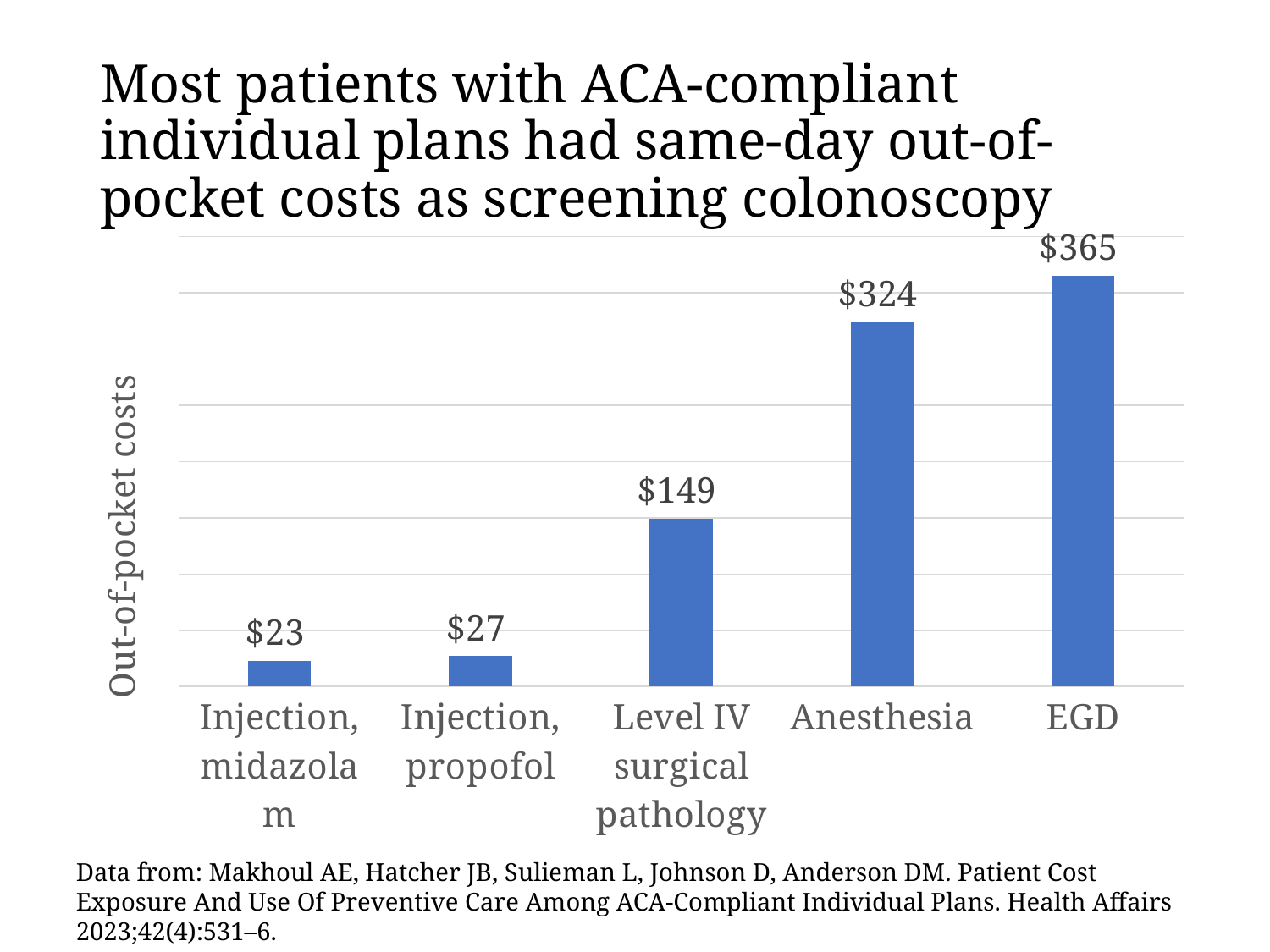
How many categories are shown in the chart? 5 Which category has the highest out-of-pocket cost? EGD Which has a higher out-of-pocket cost, Anesthesia or Level IV surgical pathology? Anesthesia What kind of chart is shown on the slide? Bar chart Which category has the lowest out-of-pocket cost? Injection, midazolam What is the difference in out-of-pocket cost between Level IV surgical pathology and Injection, midazolam? $126 What is the out-of-pocket cost for Anesthesia? $324 What is the out-of-pocket cost for Injection, propofol? $27 What is the difference in out-of-pocket cost between EGD and Anesthesia? $41 What is the out-of-pocket cost for Level IV surgical pathology? $149 What is the out-of-pocket cost for EGD? $365 What is the label of the vertical axis? Out-of-pocket costs